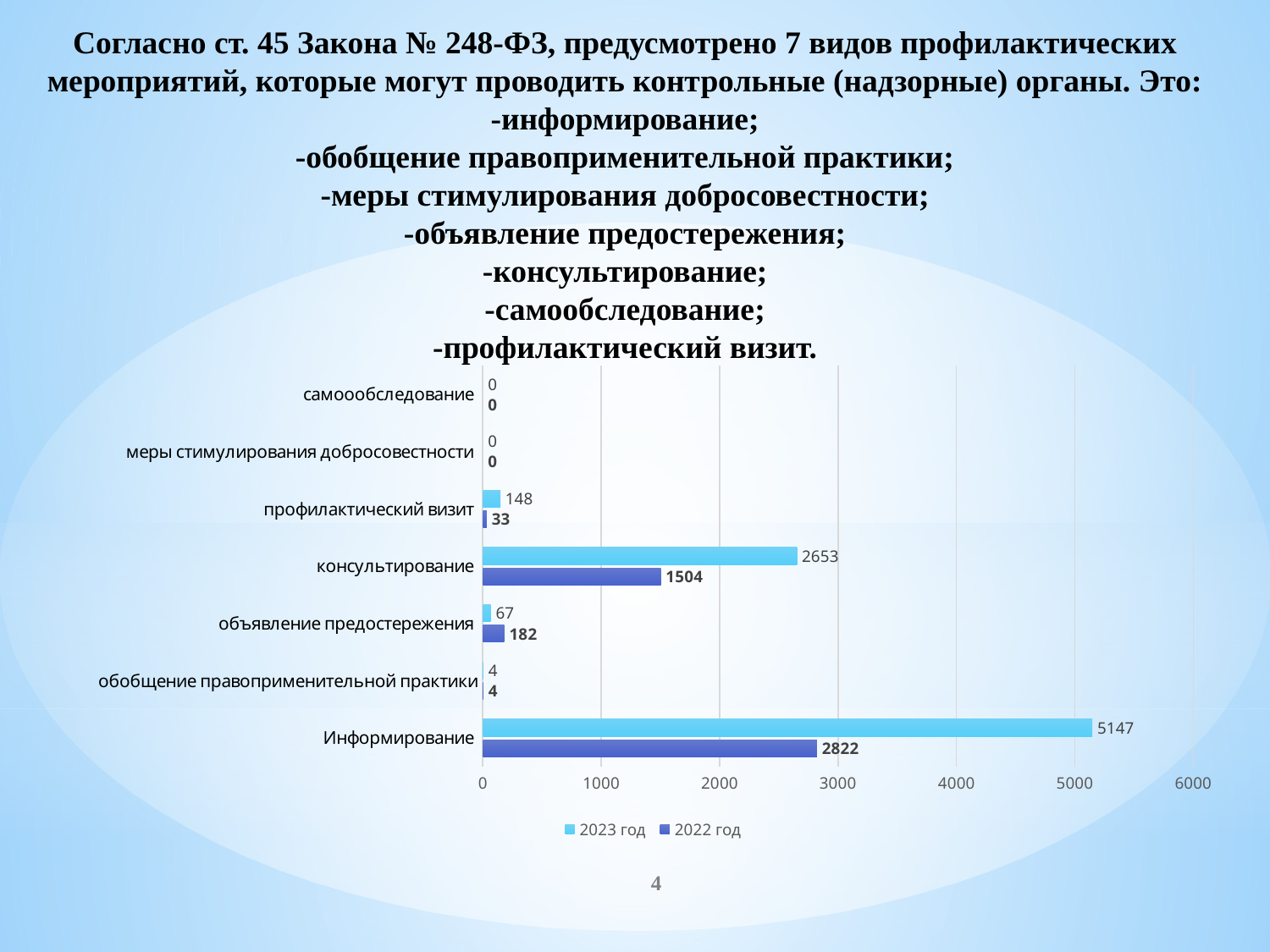
What is the value for объявление предостережения in the 2023 год series? 67 Which category has the highest value in the 2023 год series? Информирование What kind of chart is shown on the slide? bar chart What is the value for профилактический визит in the 2022 год series? 33 What is the value for консультирование in the 2022 год series? 1504 How many categories are shown on the chart? 7 What are the two series listed in the legend? 2023 год and 2022 год How many series does the legend list? 2 What is the difference between the 2023 год and 2022 год values for Информирование? 2325 What is the value for Информирование in the 2023 год series? 5147 Is the 2023 год value for консультирование greater or less than 2000? greater Which is larger for объявление предостережения: the 2023 год value or the 2022 год value? 2022 год